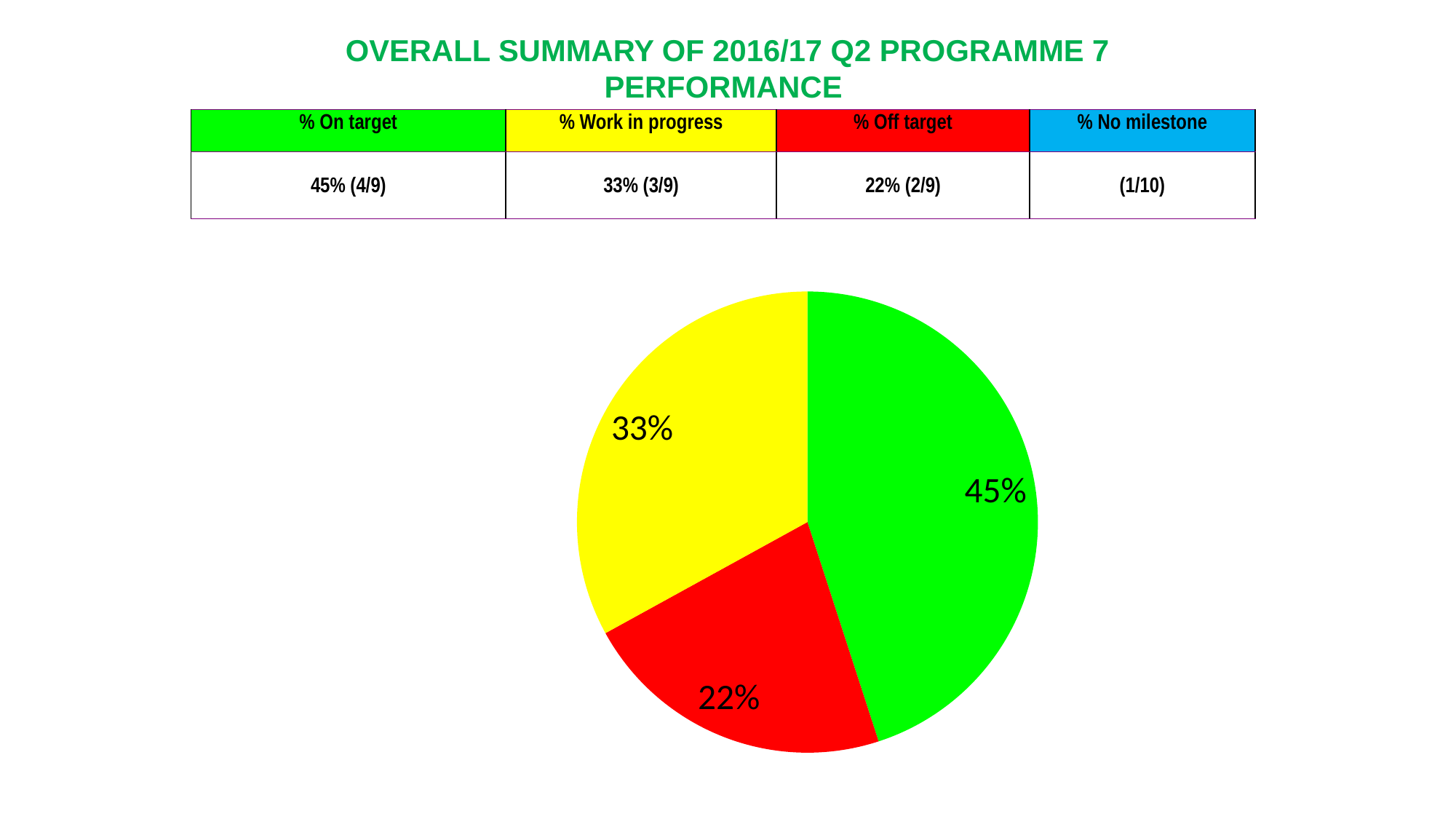
What percentage is shown on the green slice of the pie chart? 45% Which slice of the pie chart is the smallest? the red slice (22%) What percentage is shown on the red slice of the pie chart? 22% What kind of chart is shown on the slide? pie chart What is the difference between the green slice and the red slice in the pie chart? 23% According to the table above the pie chart, which category does the green colour represent? % On target Which slice of the pie chart is the largest? the green slice (45%) What percentage is shown on the yellow slice of the pie chart? 33% Does the pie chart include a slice for the '% No milestone' category? No Which is larger in the pie chart, the yellow slice or the red slice? the yellow slice How many slices does the pie chart have? 3 What is the difference between the yellow slice and the red slice in the pie chart? 11%